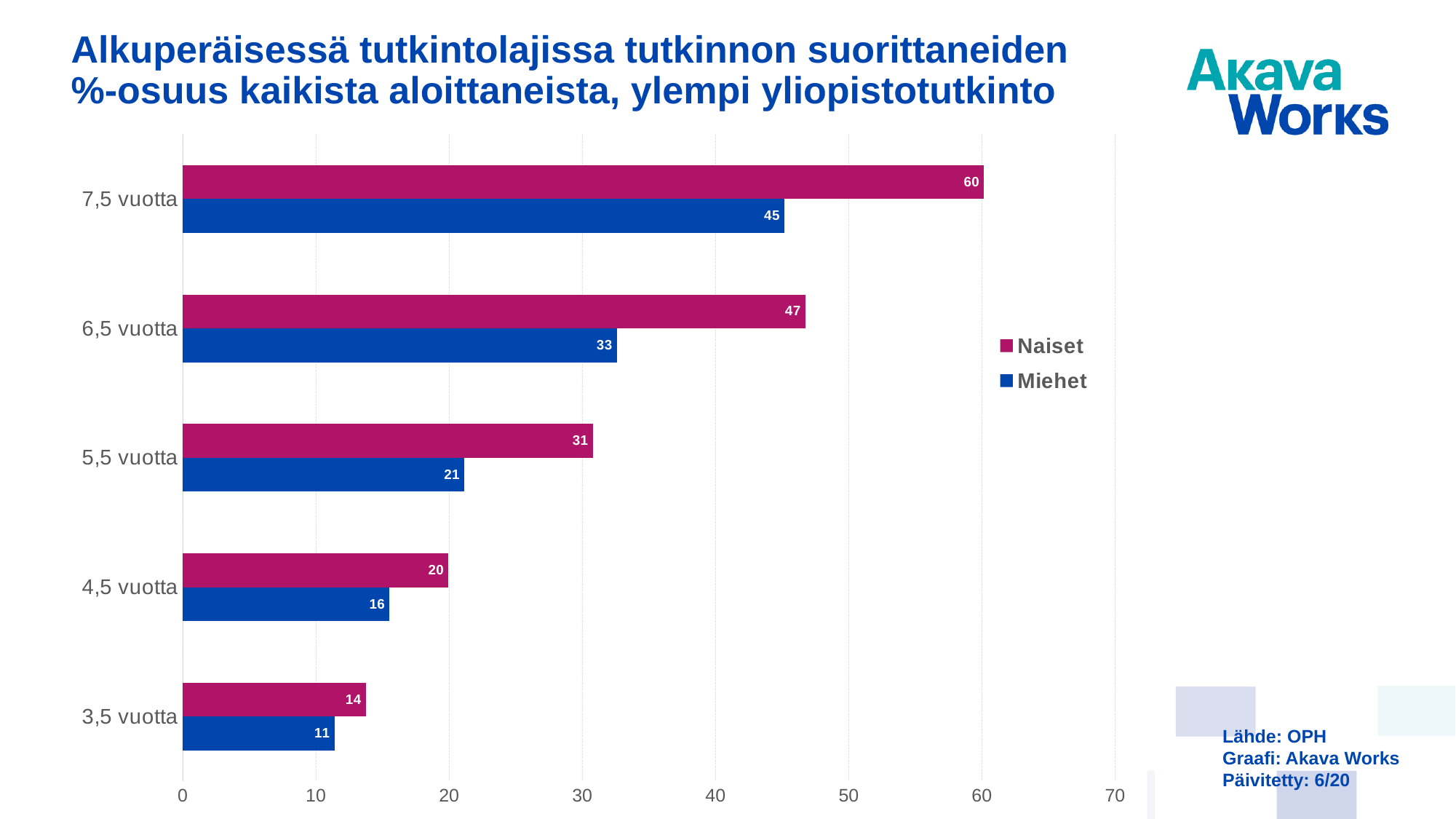
What is the value for Miehet at 6,5 vuotta? 33 How many categories are shown on the y axis? 5 What kind of chart is shown on the slide? bar chart What is the value for Naiset at 7,5 vuotta? 60 Which colour represents Miehet in the chart? blue Which is larger at 5,5 vuotta, Naiset or Miehet? Naiset What is the value for Miehet at 3,5 vuotta? 11 What is the difference between Naiset and Miehet at 6,5 vuotta? 14 Which category has the lowest value for Naiset? 3,5 vuotta Which category has the highest value for Miehet? 7,5 vuotta How many series does the legend list? 2 Is the value for Naiset at 4,5 vuotta greater or less than 30? less